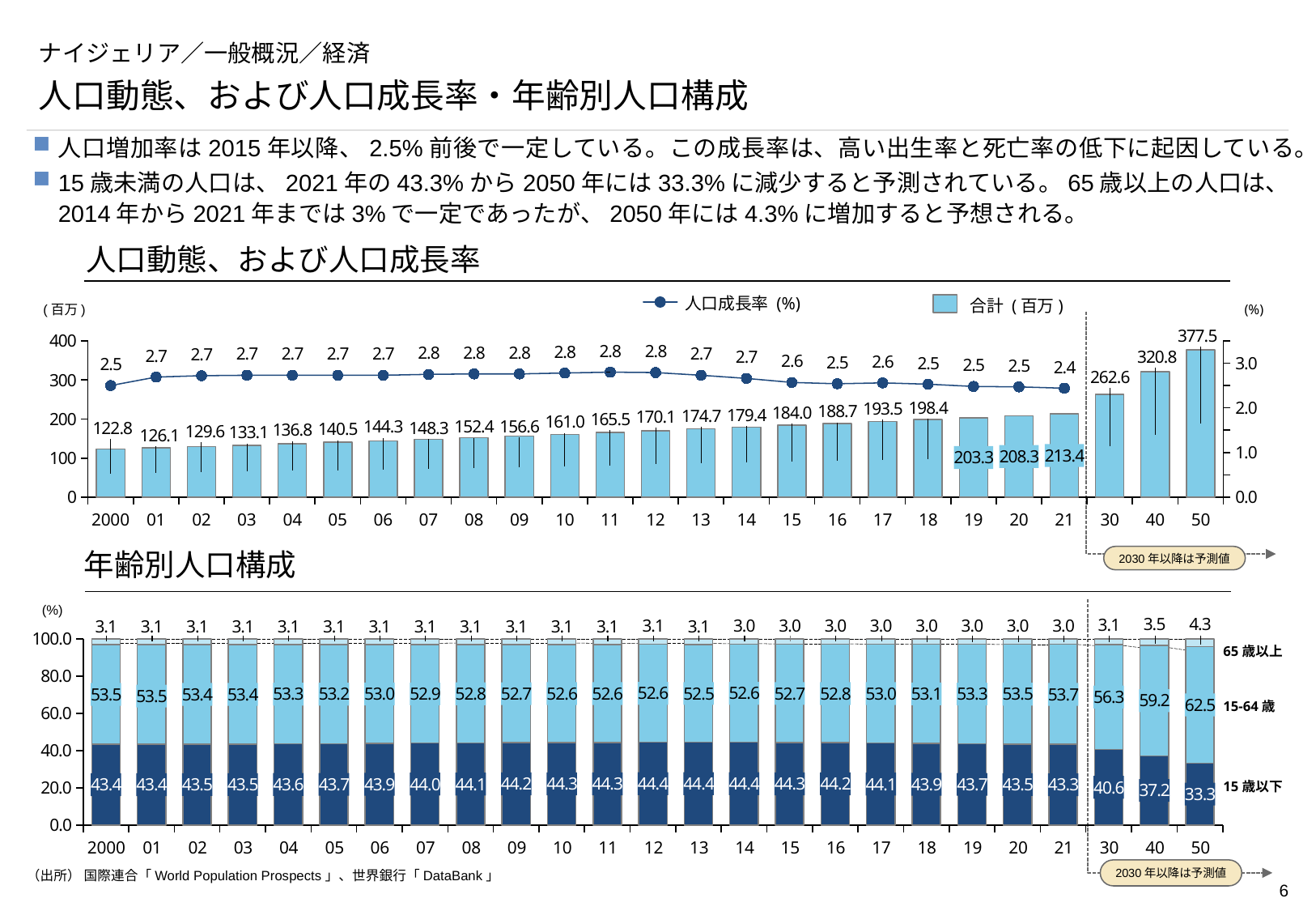
「人口動態、および人口成長率」のグラフは、どのような種類のグラフですか？ 棒グラフと折れ線グラフの複合グラフ 「人口動態、および人口成長率」のグラフで、2021年の人口成長率（%）はいくつですか？ 2.4 「年齢別人口構成」のグラフで、2050年の65歳以上の割合はいくつですか？ 4.3 「人口動態、および人口成長率」のグラフで、人口成長率は2012年と2021年のどちらが高いですか？ 2012年 「人口動態、および人口成長率」のグラフの凡例には、いくつの系列が示されていますか？ 2 「人口動態、および人口成長率」のグラフで、2050年と2021年の合計（百万）の差はいくつですか？ 164.1 「人口動態、および人口成長率」のグラフで、2021年の合計（百万）の値はいくつですか？ 213.4 「人口動態、および人口成長率」のグラフで、2050年の合計（百万）の値はいくつですか？ 377.5 「年齢別人口構成」のグラフで、2050年の15歳以下の割合はいくつですか？ 33.3 「人口動態、および人口成長率」のグラフで、合計（百万）が最も大きい年はどれですか？ 2050年 「年齢別人口構成」のグラフで、15歳以下の割合は2021年から2050年にかけて増加していますか、減少していますか？ 減少 「人口動態、および人口成長率」のグラフで、合計（百万）が最も小さい年はどれですか？ 2000年